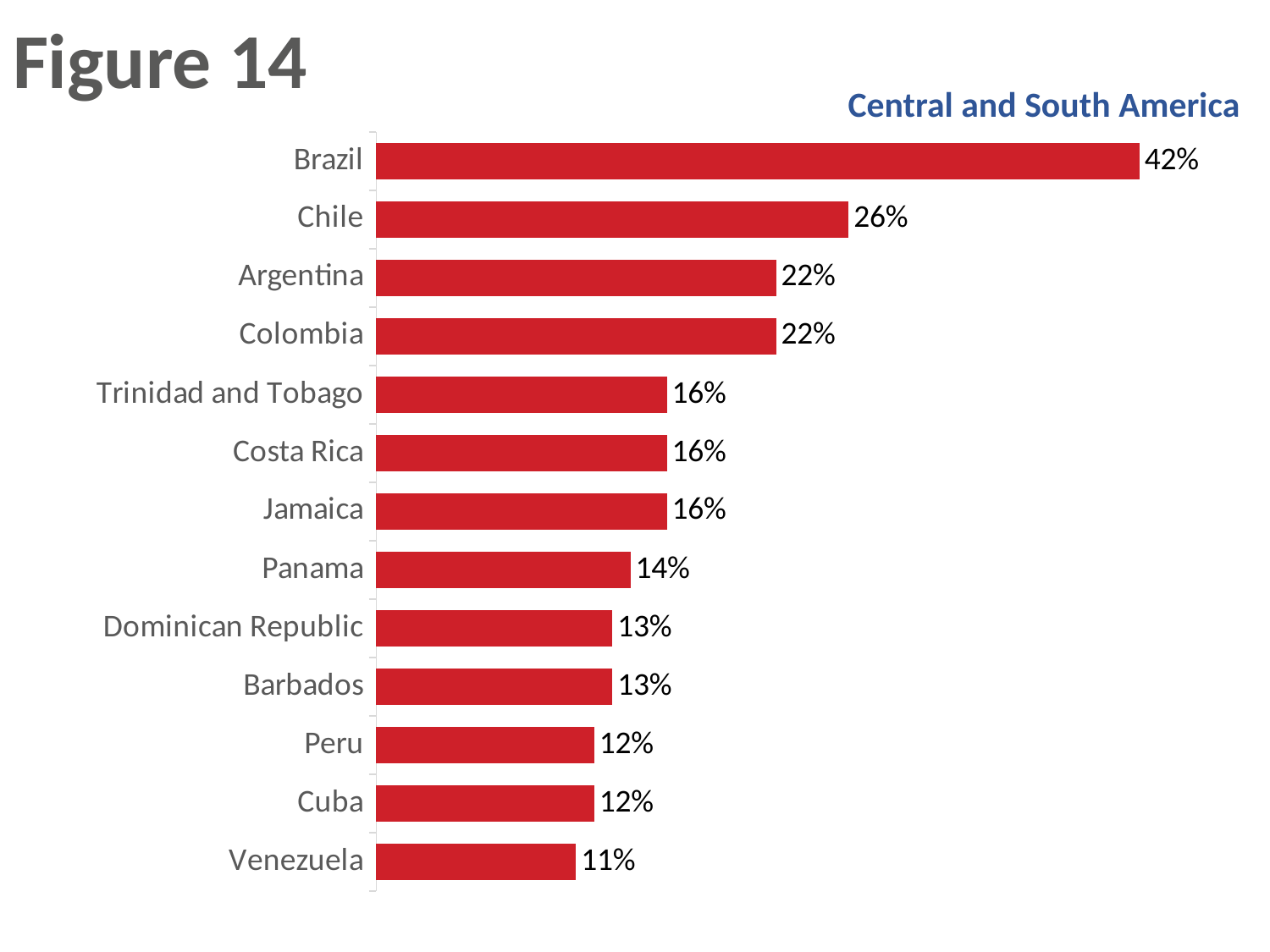
What is the value for Brazil? 42% How many countries are shown in the chart? 13 What is the difference between the values for Brazil and Chile? 16% Which is larger, the value for Chile or the value for Colombia? Chile What is the title of the chart? Central and South America Which country has the highest value? Brazil What is the difference between the values for Argentina and Peru? 10% What is the value for Chile? 26% Which country has the lowest value? Venezuela What is the value for Panama? 14% What kind of chart is shown? Bar chart What is the value for Venezuela? 11%